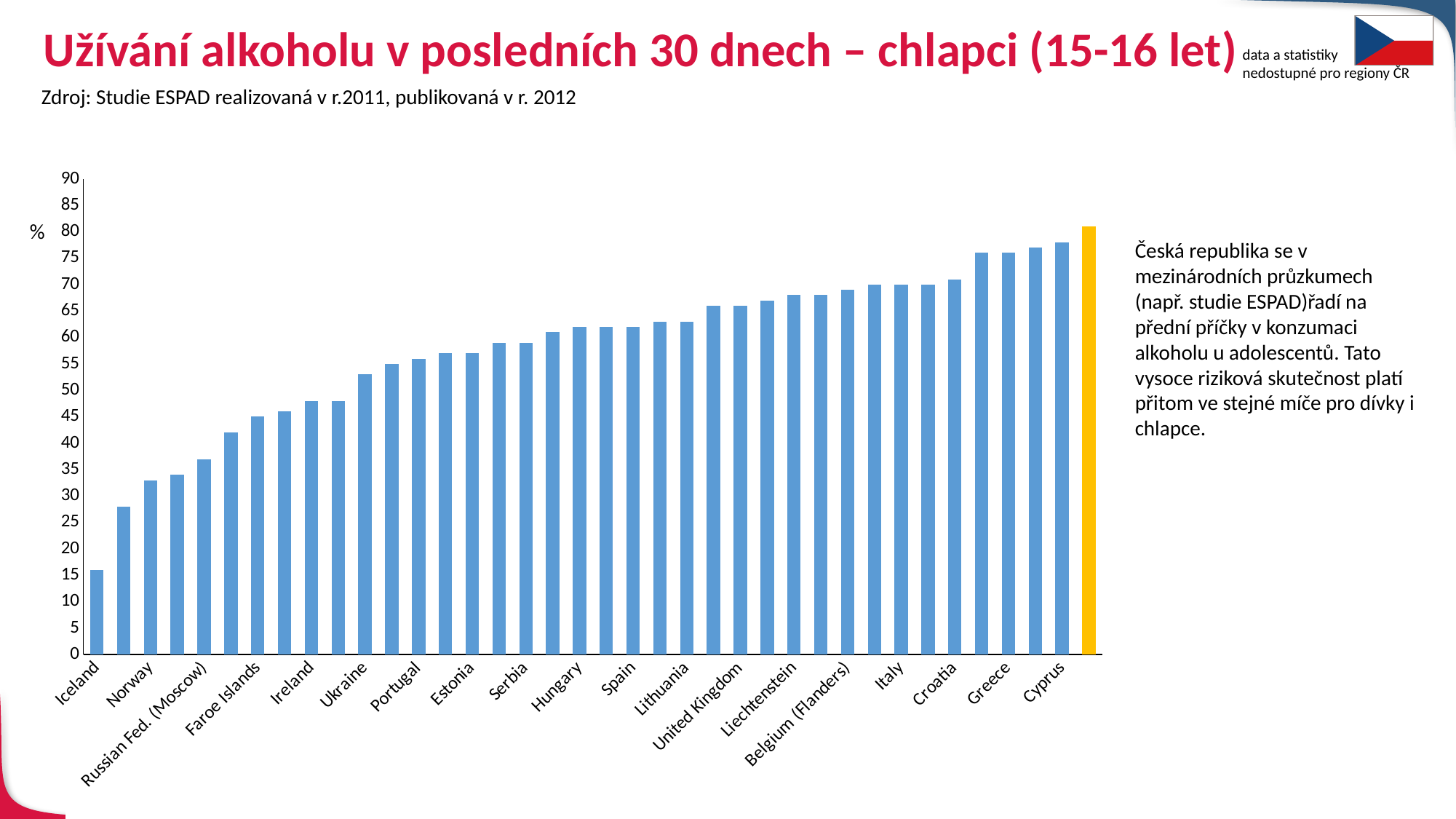
What kind of chart is shown on the slide? bar chart Is the value for Russian Fed. (Moscow) greater or less than 30? greater Is the value for Ireland greater or less than 50? less Is the value for Liechtenstein greater or less than 65? greater What unit is shown on the vertical axis of the chart? % Which has the larger value, Iceland or Norway? Norway Do the values generally rise or fall from left to right along the x axis? rise